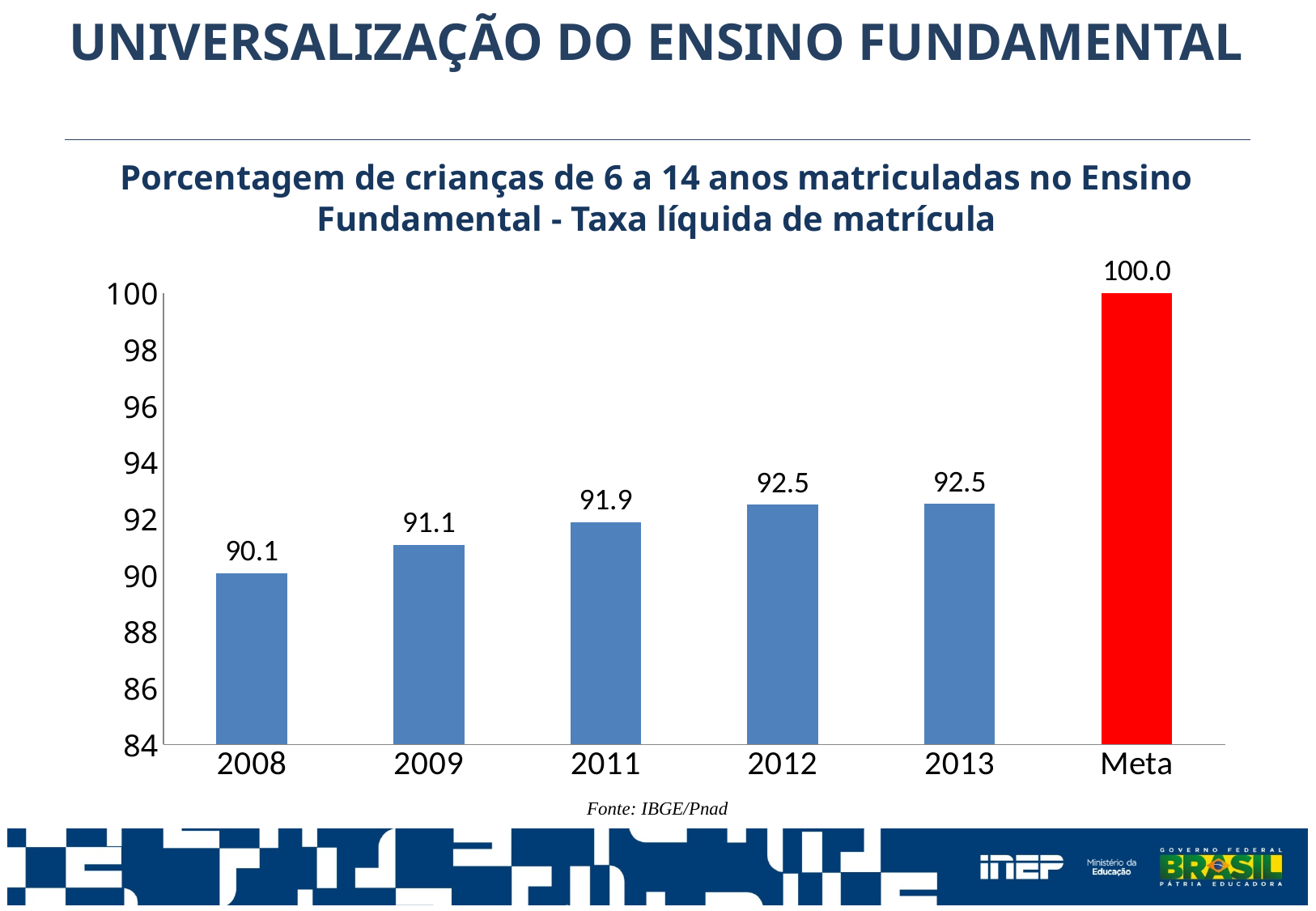
What colour is the Meta bar? Red Which is larger, the value for 2009 or the value for 2011? 2011 What is the difference between the 2009 and 2008 values? 1.0 How many bars are shown in the chart? 6 Do the values rise or fall from 2008 to 2012? Rise What kind of chart is shown on the slide? Bar chart What is the difference between the Meta value and the 2013 value? 7.5 Which category has the lowest value? 2008 Which category has the highest value? Meta What is the value for 2011? 91.9 What is the value for the Meta bar? 100.0 What is the value for 2008? 90.1